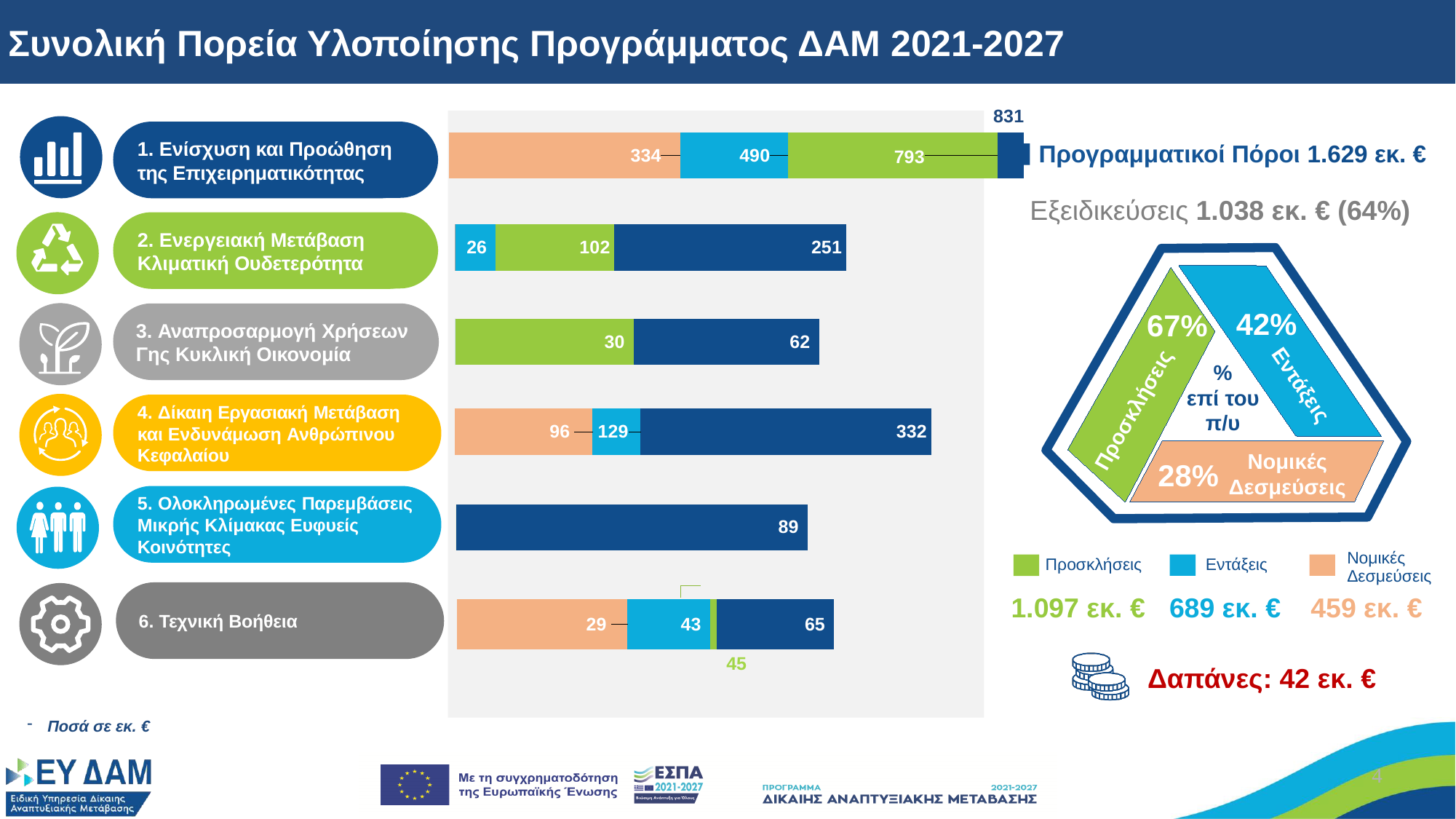
What is the dark blue value shown for category 5, Ολοκληρωμένες Παρεμβάσεις Μικρής Κλίμακας Ευφυείς Κοινότητες? 89 What is the light blue (Εντάξεις) value for category 4, Δίκαιη Εργασιακή Μετάβαση και Ενδυνάμωση Ανθρώπινου Κεφαλαίου? 129 What is the green (Προσκλήσεις) value for category 3, Αναπροσαρμογή Χρήσεων Γης Κυκλική Οικονομία? 30 Which is larger for category 2, the green (Προσκλήσεις) value or the light blue (Εντάξεις) value? green (Προσκλήσεις), 102 What unit note is given at the bottom left of the chart? Ποσά σε εκ. € What is the difference between the green (793) and light blue (490) values for category 1? 303 What is the orange (Νομικές Δεσμεύσεις) value for category 6, Τεχνική Βοήθεια? 29 How many series does the legend on the right list? 3 What kind of chart is shown on the slide? bar chart Which category has the highest dark blue value? 1. Ενίσχυση και Προώθηση της Επιχειρηματικότητας What is the green (Προσκλήσεις) value for category 1, Ενίσχυση και Προώθηση της Επιχειρηματικότητας? 793 How many priority categories (axes) are plotted in the bar chart? 6